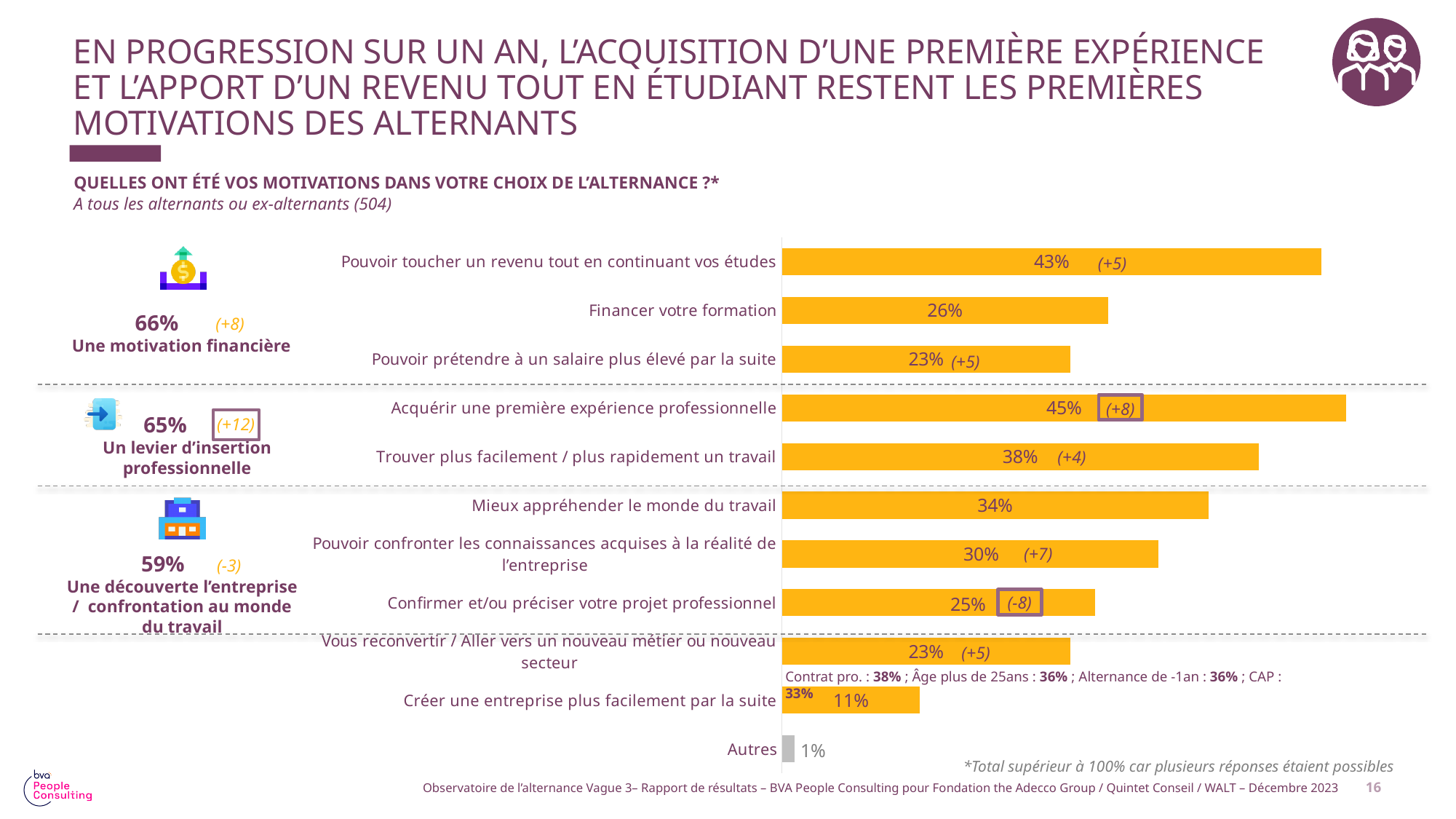
How many motivation categories are plotted in the bar chart? 11 Which motivation has the highest percentage in the chart? Acquérir une première expérience professionnelle Which is larger: the value for "Mieux appréhender le monde du travail" or the value for "Pouvoir confronter les connaissances acquises à la réalité de l'entreprise"? Mieux appréhender le monde du travail What change versus the previous year is shown next to "Acquérir une première expérience professionnelle"? (+8) What is the value shown for "Pouvoir toucher un revenu tout en continuant vos études"? 43% What is the value shown for "Créer une entreprise plus facilement par la suite"? 11% What percentage of respondents cited "Acquérir une première expérience professionnelle" as a motivation? 45% What is the difference between the values for "Pouvoir toucher un revenu tout en continuant vos études" and "Financer votre formation"? 17% What type of chart is used to display the motivations? Bar chart What is the value shown for "Financer votre formation"? 26% What is the difference between the values for "Acquérir une première expérience professionnelle" and "Trouver plus facilement / plus rapidement un travail"? 7% Which category has the lowest percentage in the chart? Autres